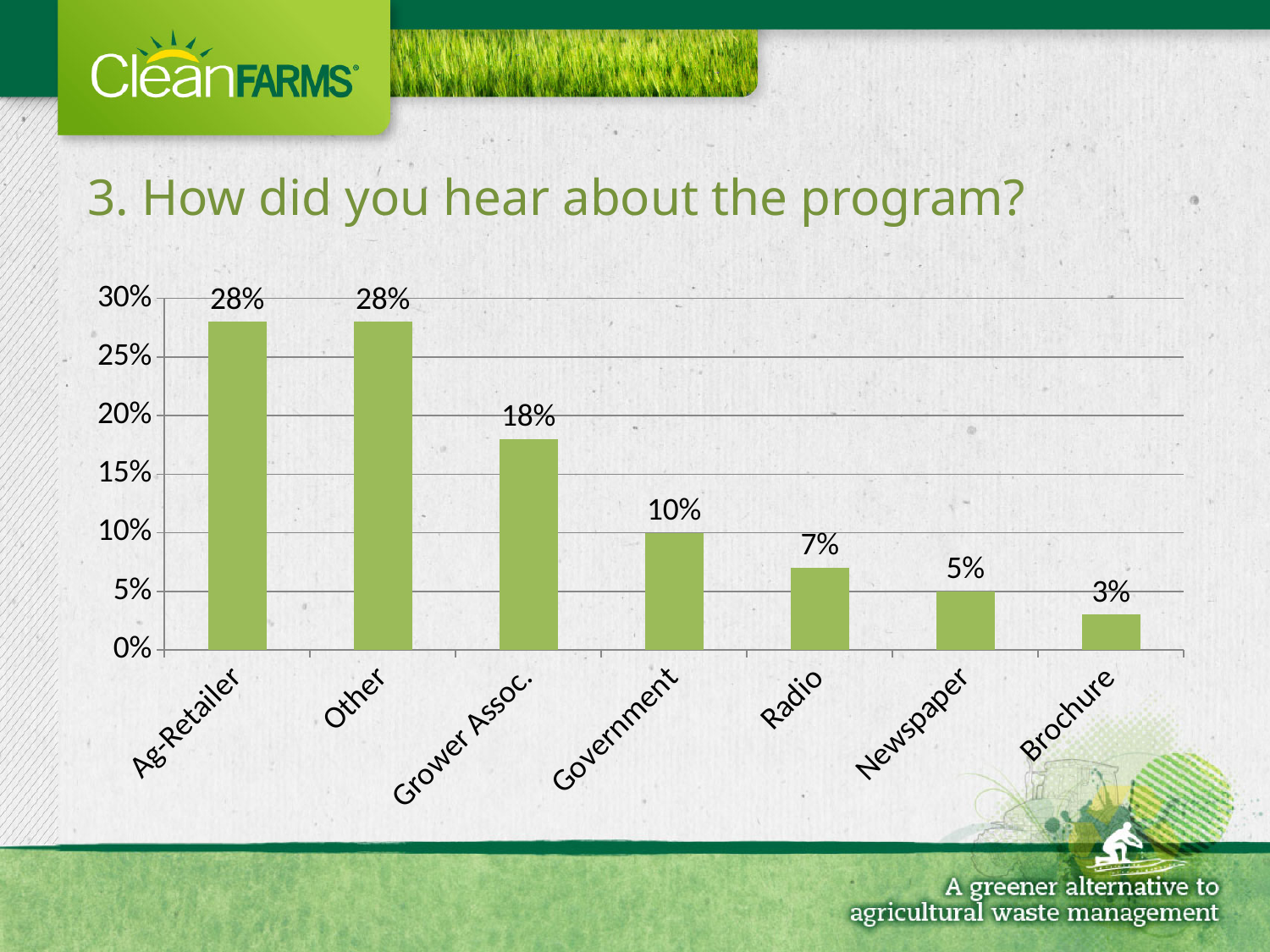
Do the values rise or fall from left to right along the x axis? fall What is the difference between the values for Ag-Retailer and Grower Assoc.? 10% What kind of chart is shown on the slide? bar chart Which category has the lowest value? Brochure What is the value shown for Radio? 7% Which is larger, the value for Radio or the value for Newspaper? Radio What is the difference between the values for Government and Newspaper? 5% What percentage of respondents heard about the program from a Grower Assoc.? 18% How many categories are shown on the x axis? 7 What is the value shown for Government? 10% Is the value for Grower Assoc. greater or less than 15%? greater What is the value shown for Brochure? 3%